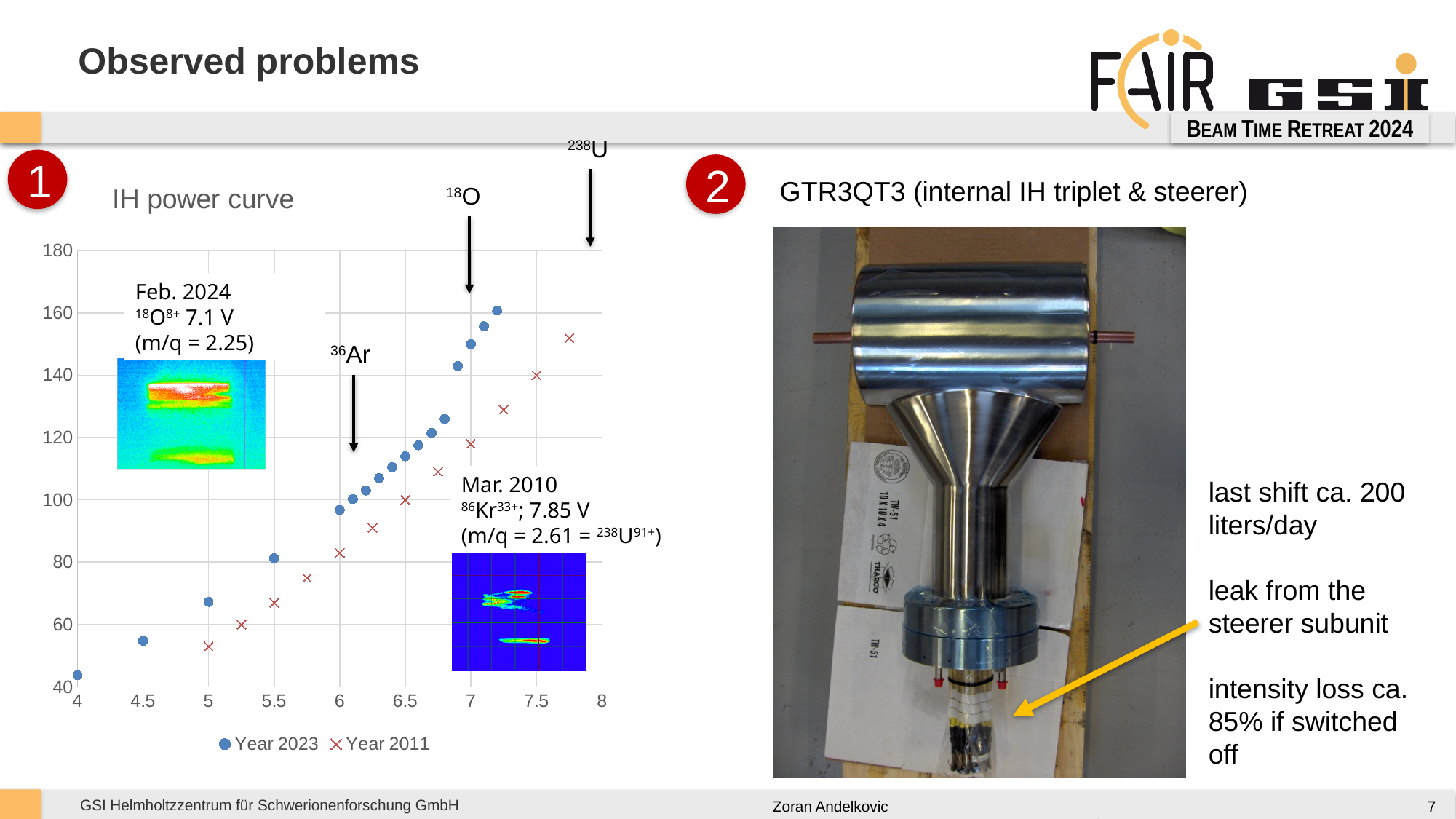
What are the two series named in the legend of the "IH power curve" chart? Year 2023 and Year 2011 In the "IH power curve" chart, is the Year 2011 value at x = 5 greater or less than 60? less In the "IH power curve" chart, is the Year 2011 value at x = 7.75 greater or less than 140? greater In the "IH power curve" chart, is the Year 2023 value at x = 7 greater or less than 140? greater What kind of chart is the "IH power curve" chart? scatter chart How many series does the legend of the "IH power curve" chart list? 2 What is the title of the chart on the left of the slide? IH power curve In the "IH power curve" chart, do the Year 2023 values rise or fall as the x value increases? rise In the "IH power curve" chart, at x = 5, which series has the larger value, Year 2023 or Year 2011? Year 2023 In the "IH power curve" chart, at x = 7, which series has the larger value, Year 2023 or Year 2011? Year 2023 How many Year 2011 data points are plotted in the "IH power curve" chart? 12